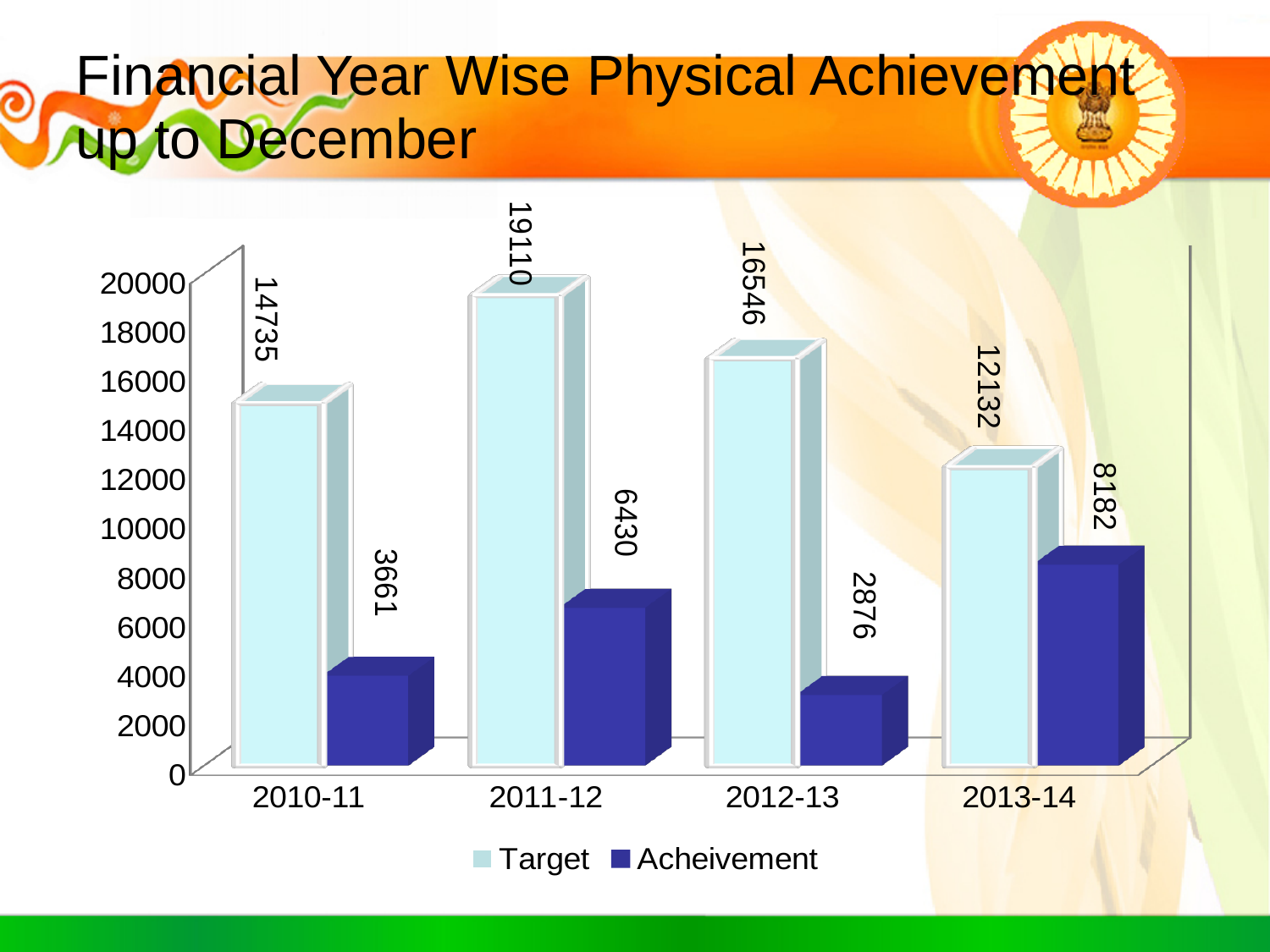
What is the Target value for 2011-12? 19110 What is the Achievement value for 2012-13? 2876 What is the difference between Target and Achievement in 2010-11? 11074 Which financial year has the highest Target? 2011-12 Which series is shown in dark blue according to the legend? Acheivement How many series does the legend list? 2 What is the difference between the Achievement in 2013-14 and the Achievement in 2011-12? 1752 How many financial years are shown on the x axis? 4 What is the Achievement value for 2013-14? 8182 Which is larger, the Target for 2012-13 or the Target for 2013-14? Target for 2012-13 Which financial year has the lowest Achievement? 2012-13 What kind of chart is shown on the slide? Bar chart